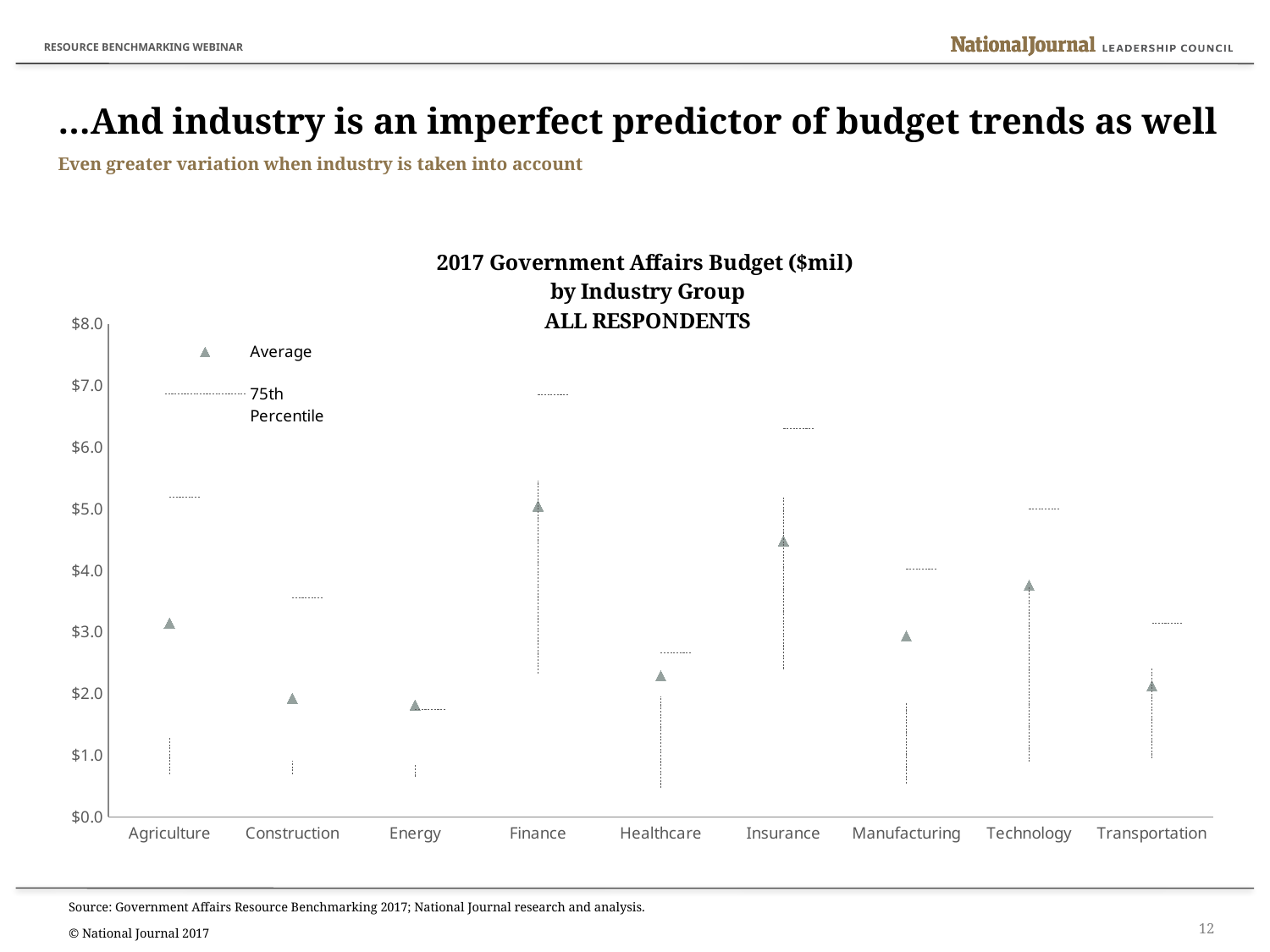
Which industry group has the highest 75th Percentile value? Finance Which industry group has the lowest 75th Percentile value? Energy How many industry groups are shown on the x axis? 9 Is the Average value for Finance greater or less than $4.0? greater How many series does the legend list? 2 Which has the larger 75th Percentile value, Agriculture or Construction? Agriculture Which industry group has the highest Average 2017 Government Affairs Budget? Finance Is the 75th Percentile value for Insurance greater or less than $6.0? greater Is the Average value for Transportation greater or less than $3.0? less Which has the larger Average value, Insurance or Manufacturing? Insurance